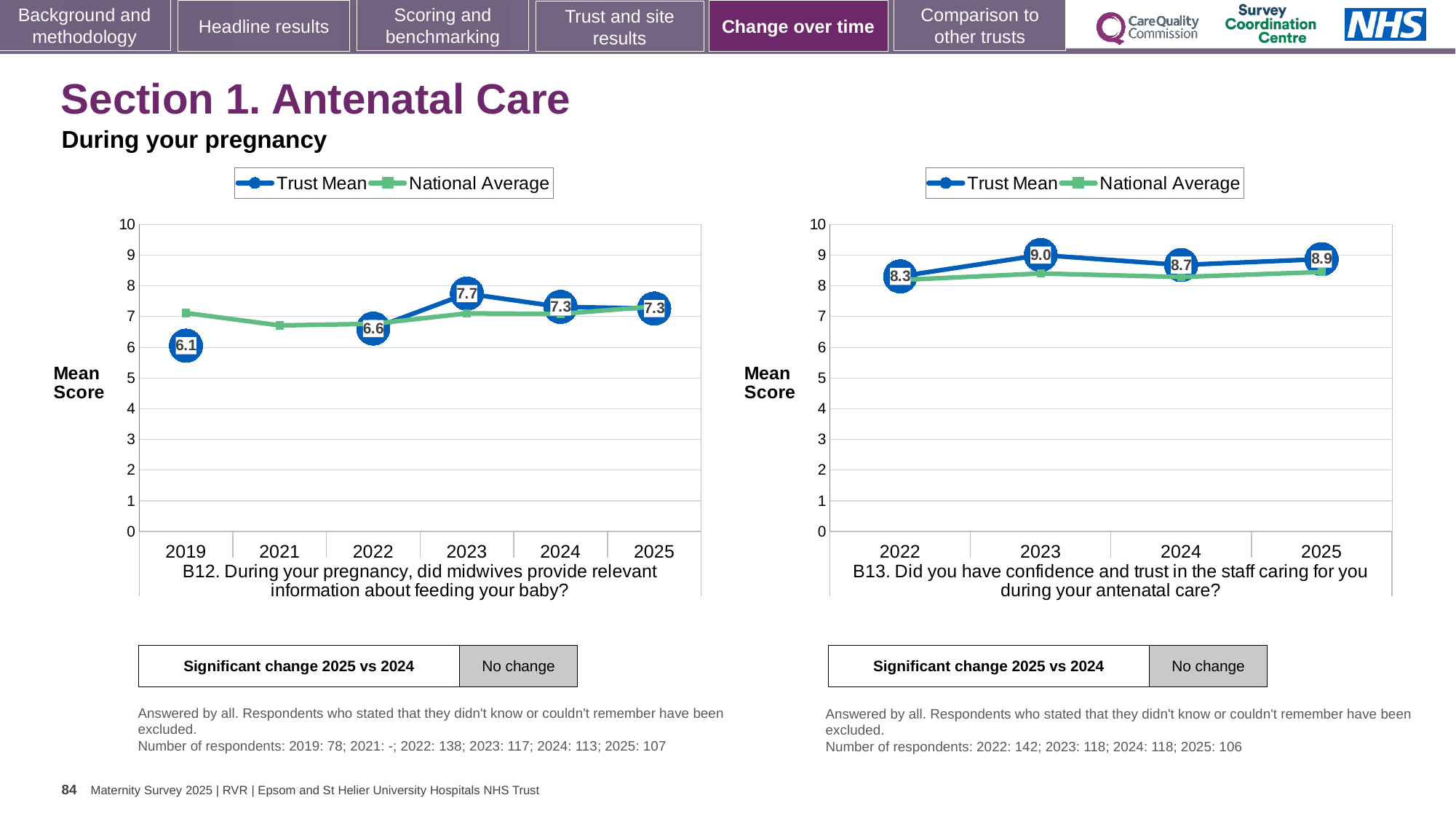
On the left chart (B12), what is the Trust Mean score for 2023? 7.7 On the left chart (B12), is the National Average for 2021 greater or less than 7? less How many series does the legend of the right chart (B13) list? 2 On the left chart (B12), in which year is the Trust Mean lowest? 2019 How many years are shown on the x axis of the left chart (B12)? 6 On the left chart (B12), what is the difference between the Trust Mean in 2023 and in 2019? 1.6 On the right chart (B13), is the Trust Mean higher in 2025 or in 2024? 2025 On the left chart (B12), in which year is the Trust Mean highest? 2023 On the right chart (B13), in which year is the Trust Mean highest? 2023 On the right chart (B13), what is the difference between the Trust Mean in 2023 and in 2022? 0.7 On the right chart (B13), what is the Trust Mean score for 2022? 8.3 What kind of chart is the right chart (B13)? Line chart